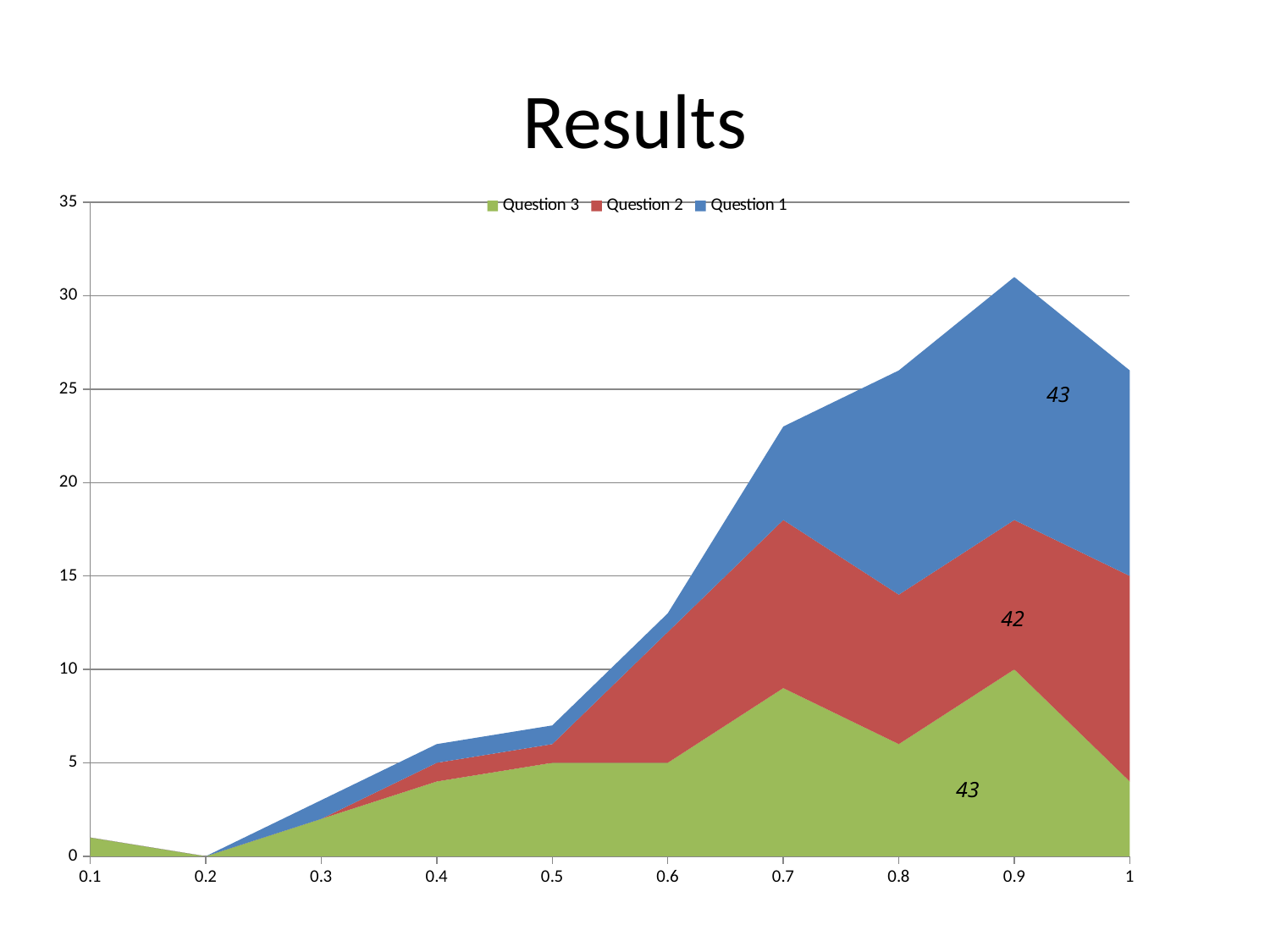
Is the stacked total at x = 0.4 greater or less than 10? less What is the value of Question 3 at x = 0.9? 10 At which x value is the stacked total highest? 0.9 How many series does the legend list? 3 Is the stacked total larger at x = 0.9 or at x = 1? 0.9 Is the stacked total at x = 0.9 greater or less than 30? greater Is the stacked total at x = 0.7 greater or less than 20? greater How many points are there along the x axis? 10 What is the title of the chart? Results What kind of chart is shown on the slide? area chart Which series is plotted at the bottom of the stack (in green)? Question 3 What is the value of Question 3 at x = 0.5? 5